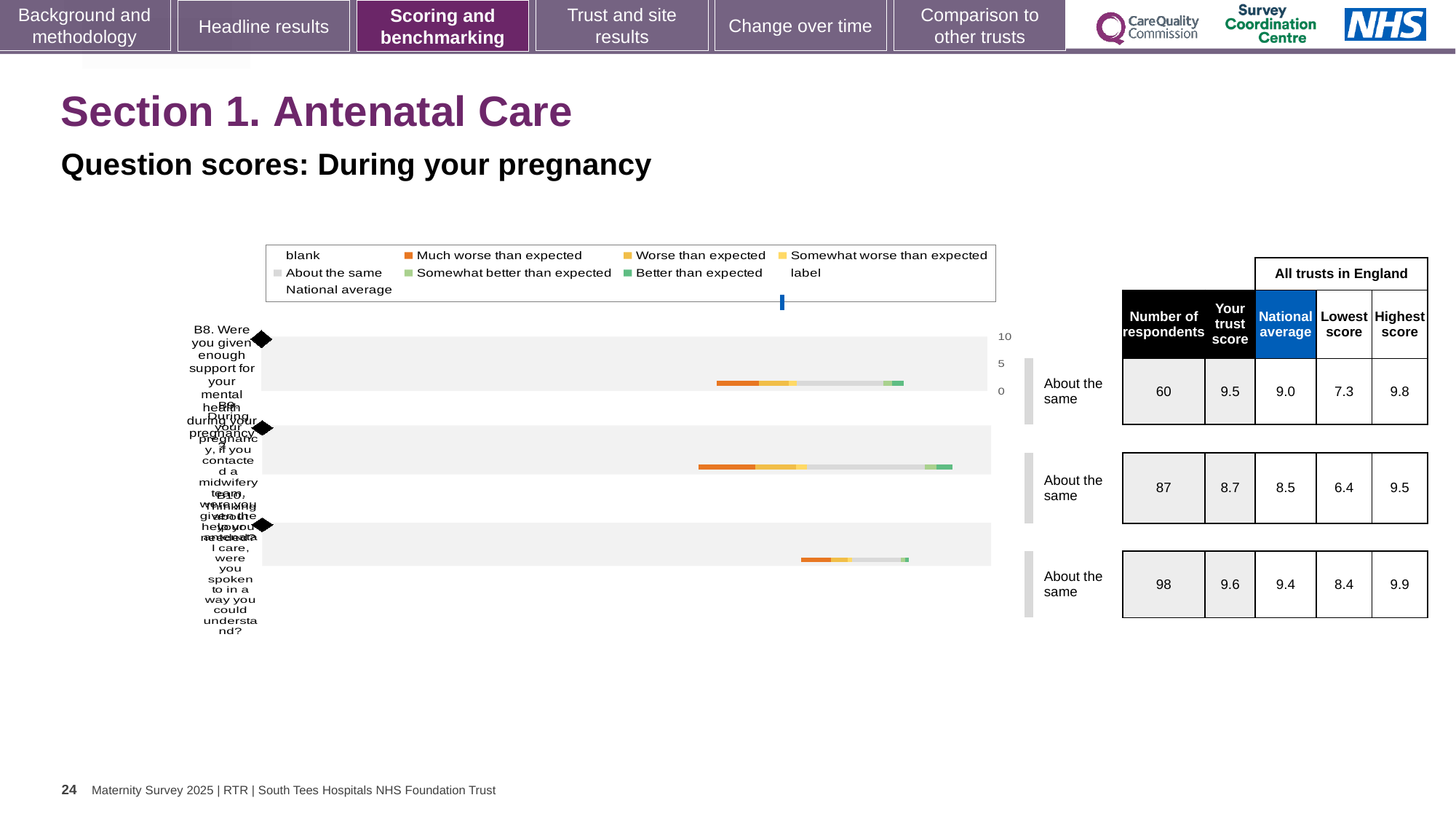
By how much does the trust's score for question B8 exceed the national average? 0.5 How many respondents are shown for question B8 (support for your mental health during pregnancy)? 60 Is the trust's score for question B8 higher or lower than the national average? higher What is the largest number of respondents shown in the table on this slide? 98 What is the lowest 'Lowest score' value shown in the table on this slide? 6.4 What is the national average for question B8 (support for your mental health during pregnancy)? 9.0 What is the trust's score for question B8 (support for your mental health during pregnancy)? 9.5 What is the difference between the highest score and the lowest score for the second question row? 3.1 What kind of chart is shown on this slide? bar chart What is the highest score among all trusts in England for the third question row? 9.9 What is the lowest score among all trusts in England for the first question row (B8)? 7.3 How many questions are plotted in the chart on this slide? 3